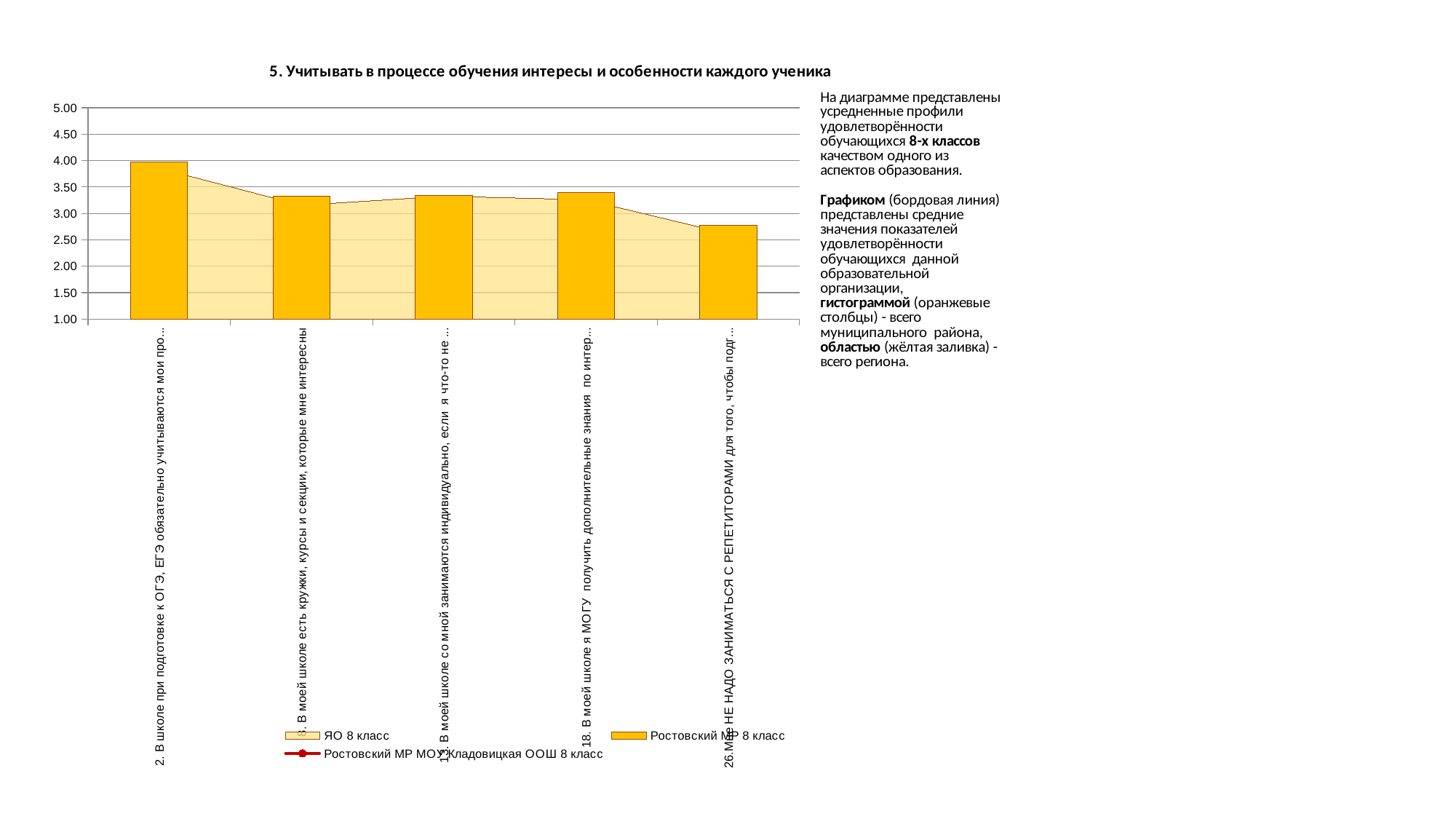
Which category has the lowest orange bar (Ростовский МР 8 класс)? 26. МНЕ НЕ НАДО ЗАНИМАТЬСЯ С РЕПЕТИТОРАМИ для того, чтобы подг... Which has the larger Ростовский МР 8 класс value: category 18 (дополнительные знания) or category 26 (НЕ НАДО ЗАНИМАТЬСЯ С РЕПЕТИТОРАМИ)? Category 18 (дополнительные знания) Which series is shown with the yellow filled area in the chart? ЯО 8 класс Is the Ростовский МР 8 класс value for category 2 (подготовка к ОГЭ, ЕГЭ) greater or less than 3.50? greater How many categories are shown on the x axis of the chart? 5 Is the Ростовский МР 8 класс value for category 26 (НЕ НАДО ЗАНИМАТЬСЯ С РЕПЕТИТОРАМИ) greater or less than 3.00? less Is the Ростовский МР 8 класс value for category 26 greater or less than 2.50? greater What is the title of the chart? 5. Учитывать в процессе обучения интересы и особенности каждого ученика Which category has the highest orange bar (Ростовский МР 8 класс)? 2. В школе при подготовке к ОГЭ, ЕГЭ обязательно учитываются мои про... Which has the larger Ростовский МР 8 класс value: category 2 (подготовка к ОГЭ, ЕГЭ) or category 8 (кружки, курсы и секции)? Category 2 (подготовка к ОГЭ, ЕГЭ) How many series does the chart legend list? 3